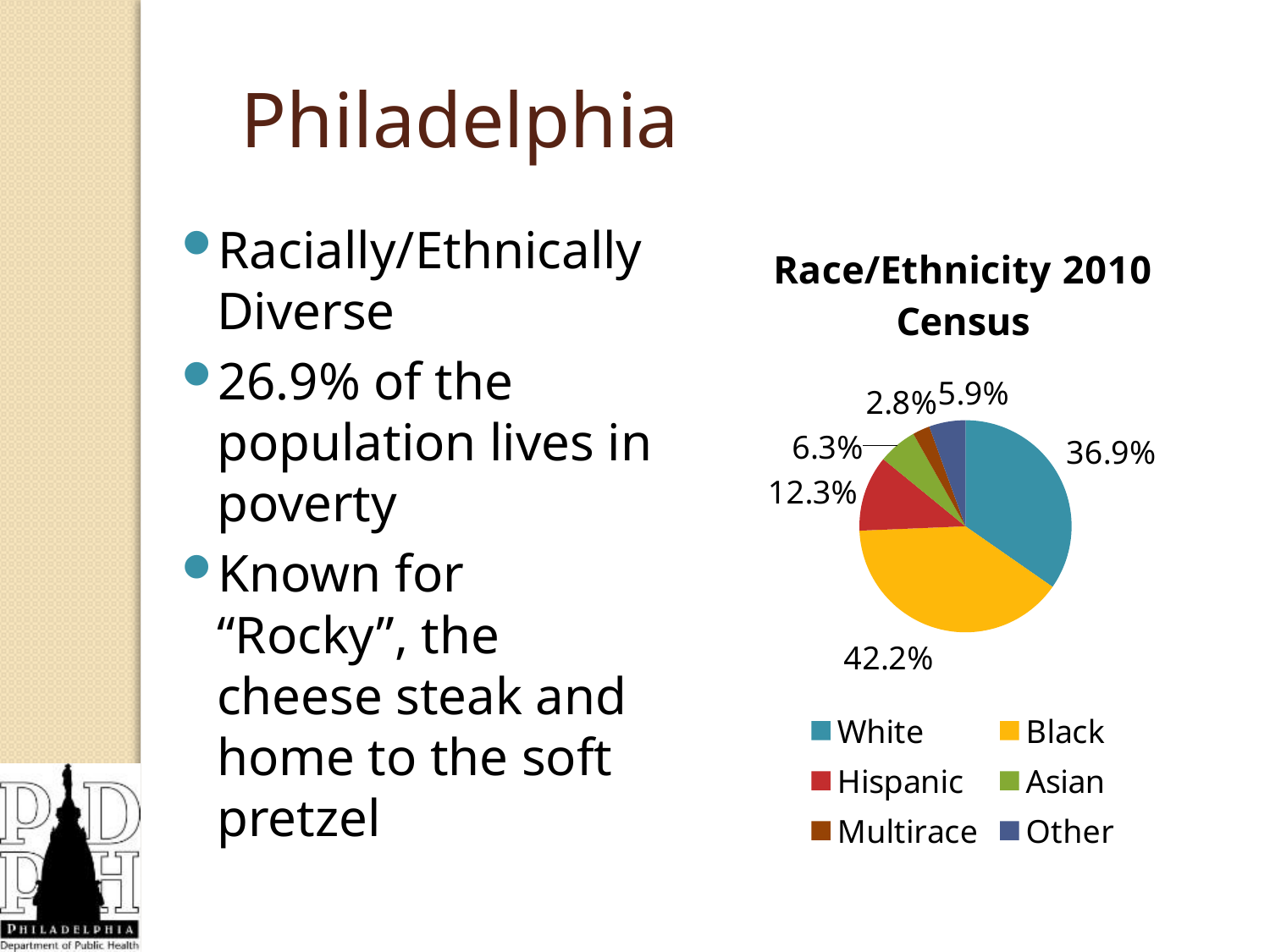
What percentage of the pie is the Hispanic slice? 12.3% What percentage of the pie is the White slice? 36.9% What is the difference between the Black share and the White share? 5.3% What percentage of the pie is the Multirace slice? 2.8% What is the title of the chart? Race/Ethnicity 2010 Census What type of chart is shown on the slide? pie chart Which category has the smallest share of the pie? Multirace What percentage of the pie is the Black slice? 42.2% Which is larger, the Asian share or the Other share? Asian What percentage of the pie is the Asian slice? 6.3% How many categories does the legend list? 6 Which category has the largest share of the pie? Black